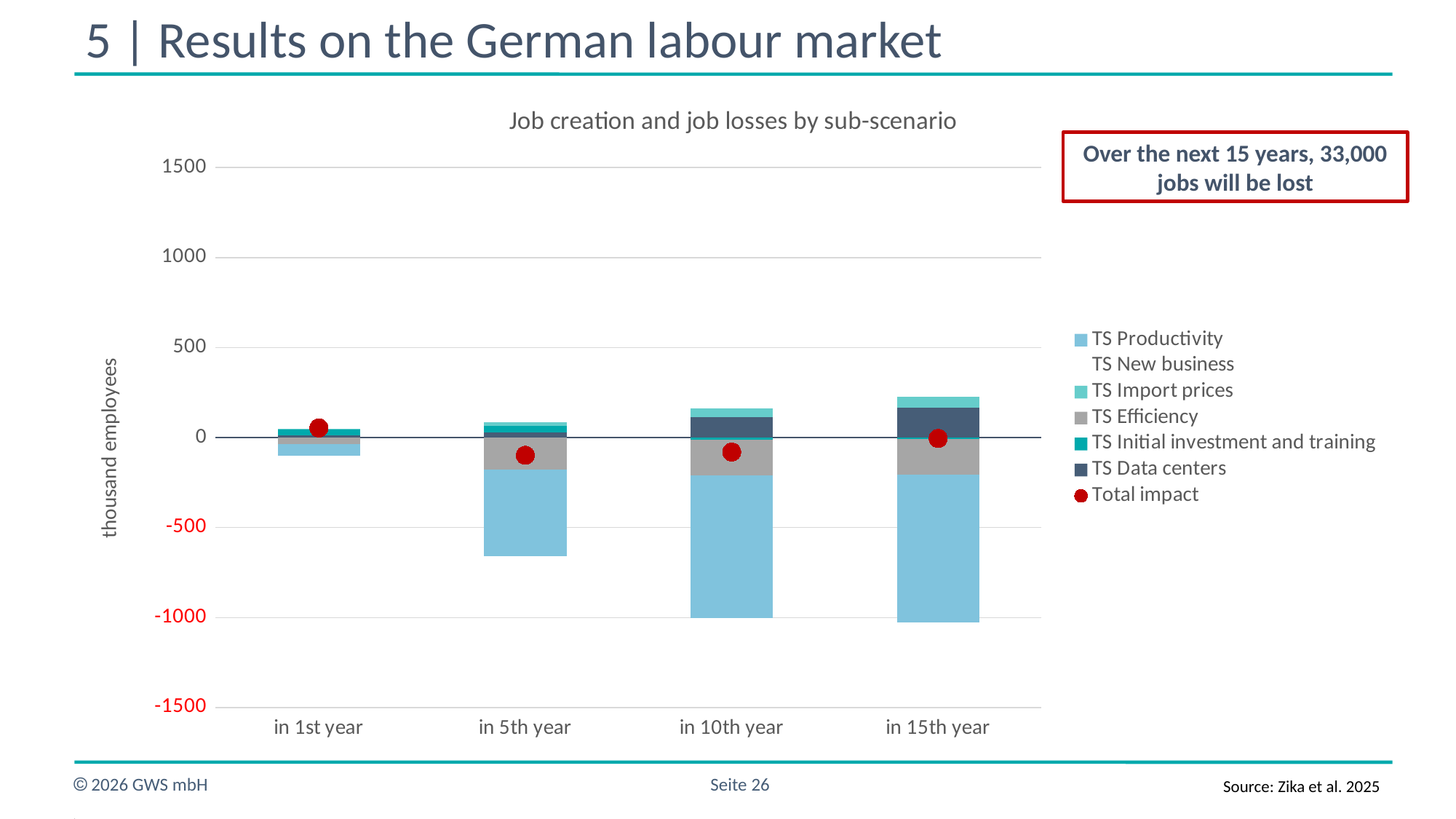
Which is larger, the Total impact in 1st year or the Total impact in 5th year? in 1st year What kind of chart is shown on the slide? stacked bar chart Is the value for TS Productivity in 1st year greater or less than -500? greater Is the Total impact value in 5th year greater or less than 0? less Which category has the smallest job loss (least negative bar) for TS Productivity? in 1st year Does the TS Productivity value rise or fall from the 1st year to the 15th year? fall What is the label of the vertical axis of the chart? thousand employees Is the value for TS Productivity in 10th year greater or less than -500? less How many categories are shown on the x axis of the chart? 4 What is the title of the chart? Job creation and job losses by sub-scenario How many series does the legend of the chart list? 7